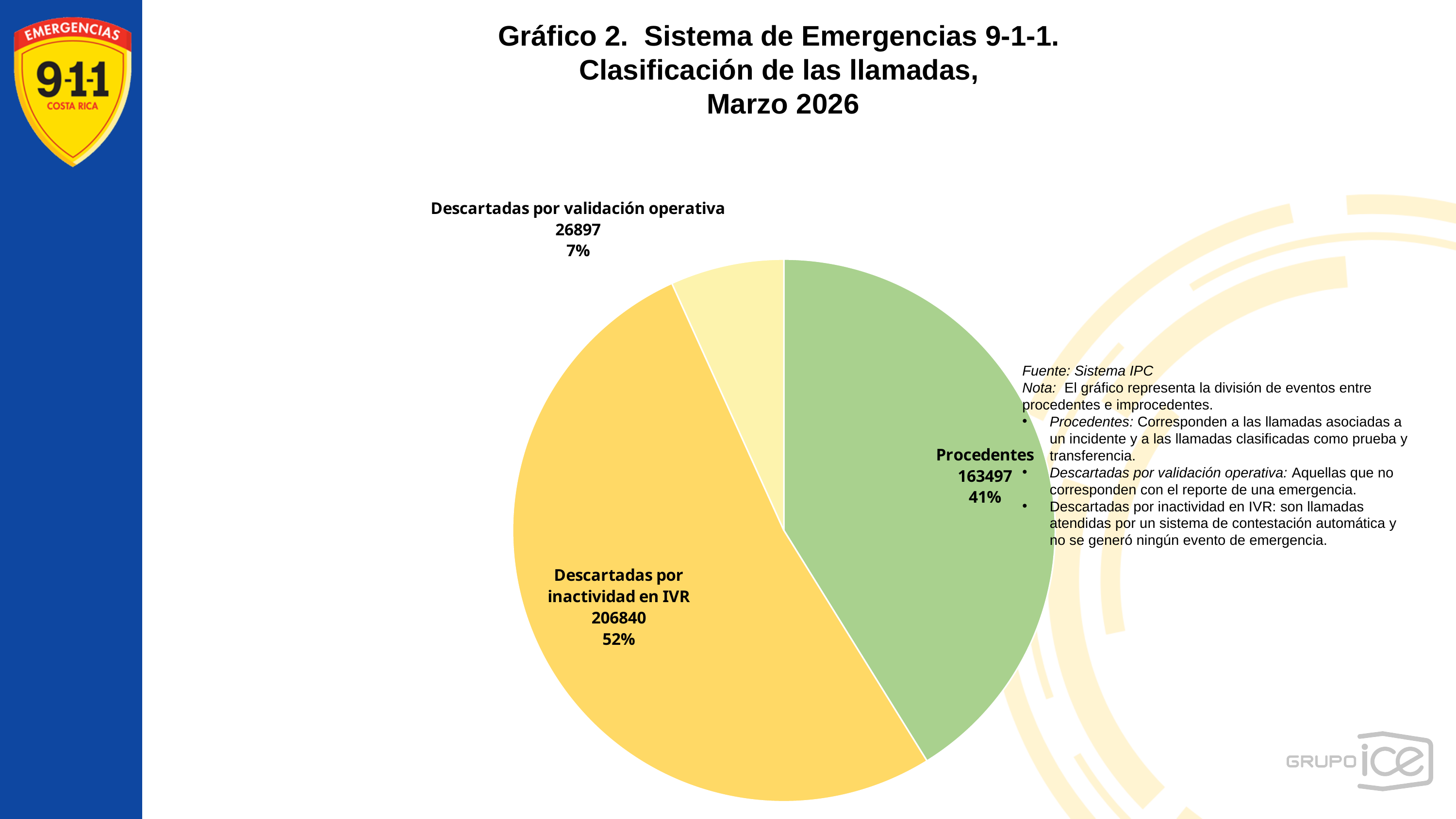
Which category has the largest slice? Descartadas por inactividad en IVR What is the difference between the values for Descartadas por inactividad en IVR and Procedentes? 43343 Which is larger, Procedentes or Descartadas por validación operativa? Procedentes How many slices does the pie chart have? 3 What kind of chart is shown on the slide? Pie chart What is the value for Descartadas por inactividad en IVR? 206840 Which category has the smallest slice? Descartadas por validación operativa What share of the pie does Descartadas por inactividad en IVR represent? 52% What colour is the Procedentes slice? Green What is the value for Procedentes? 163497 What share of the pie does Procedentes represent? 41% What is the value for Descartadas por validación operativa? 26897